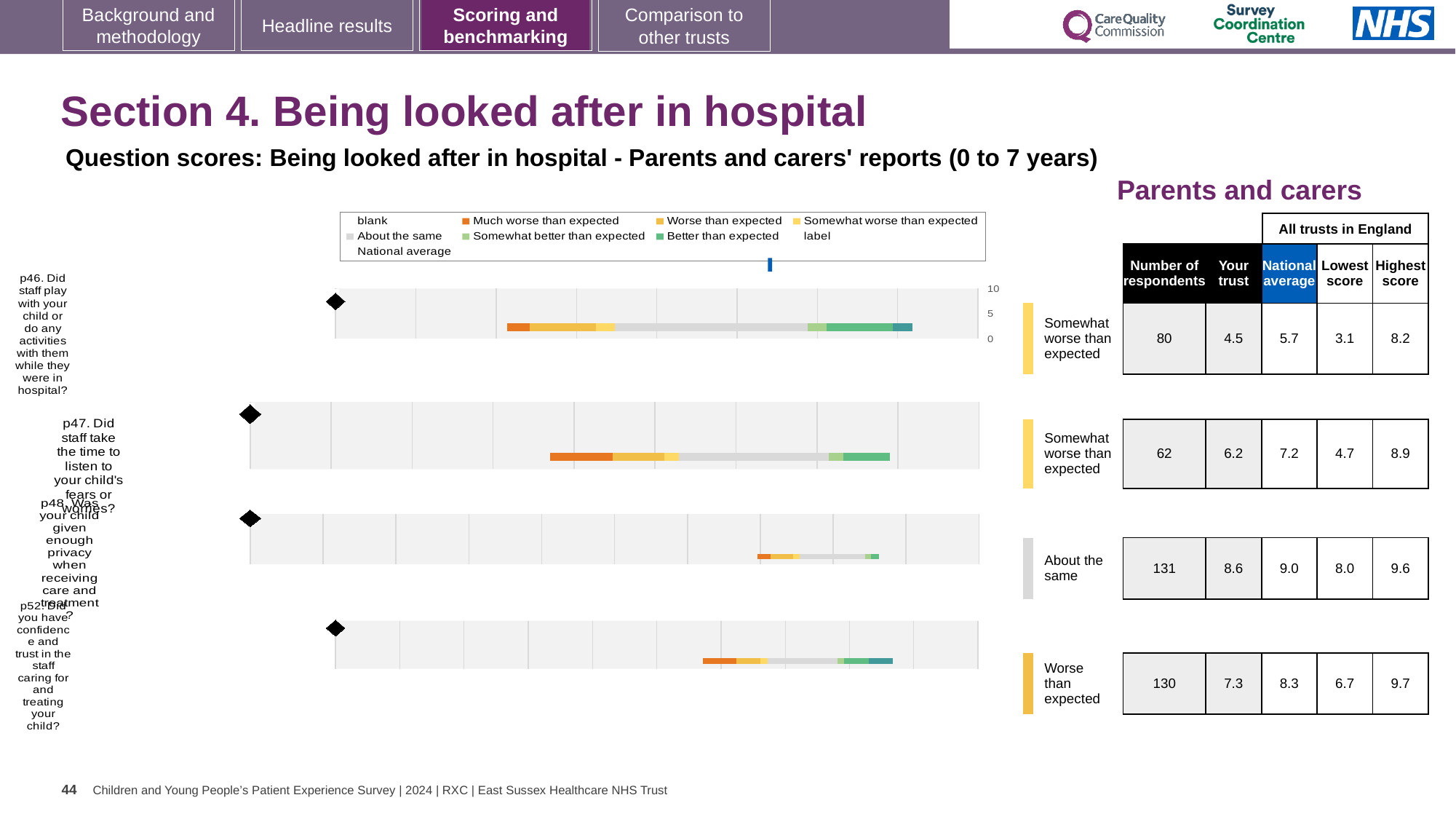
What type of chart is used to show the question scores on this slide? bar chart For the p47 chart (Did staff take the time to listen to your child's fears or worries?), how many respondents are listed? 62 How many question charts (rows) are plotted on the slide? 4 Which question chart has the lowest 'Your trust' score? p46 For the p48 chart (Was your child given enough privacy...), what is the highest score among all trusts in England? 9.6 For the p47 chart, which is larger: the 'Your trust' score or the national average? National average For the p48 chart, what is the difference between the national average and the 'Your trust' score? 0.4 For the p46 chart (Did staff play with your child...), what is the 'Your trust' score shown in the table? 4.5 For the p52 chart (Did you have confidence and trust in the staff...), what is the lowest score among all trusts in England? 6.7 For the p46 chart, what is the national average score shown in the table? 5.7 What benchmark rating label is shown next to the p52 chart? Worse than expected Which question chart has the highest 'Your trust' score? p48